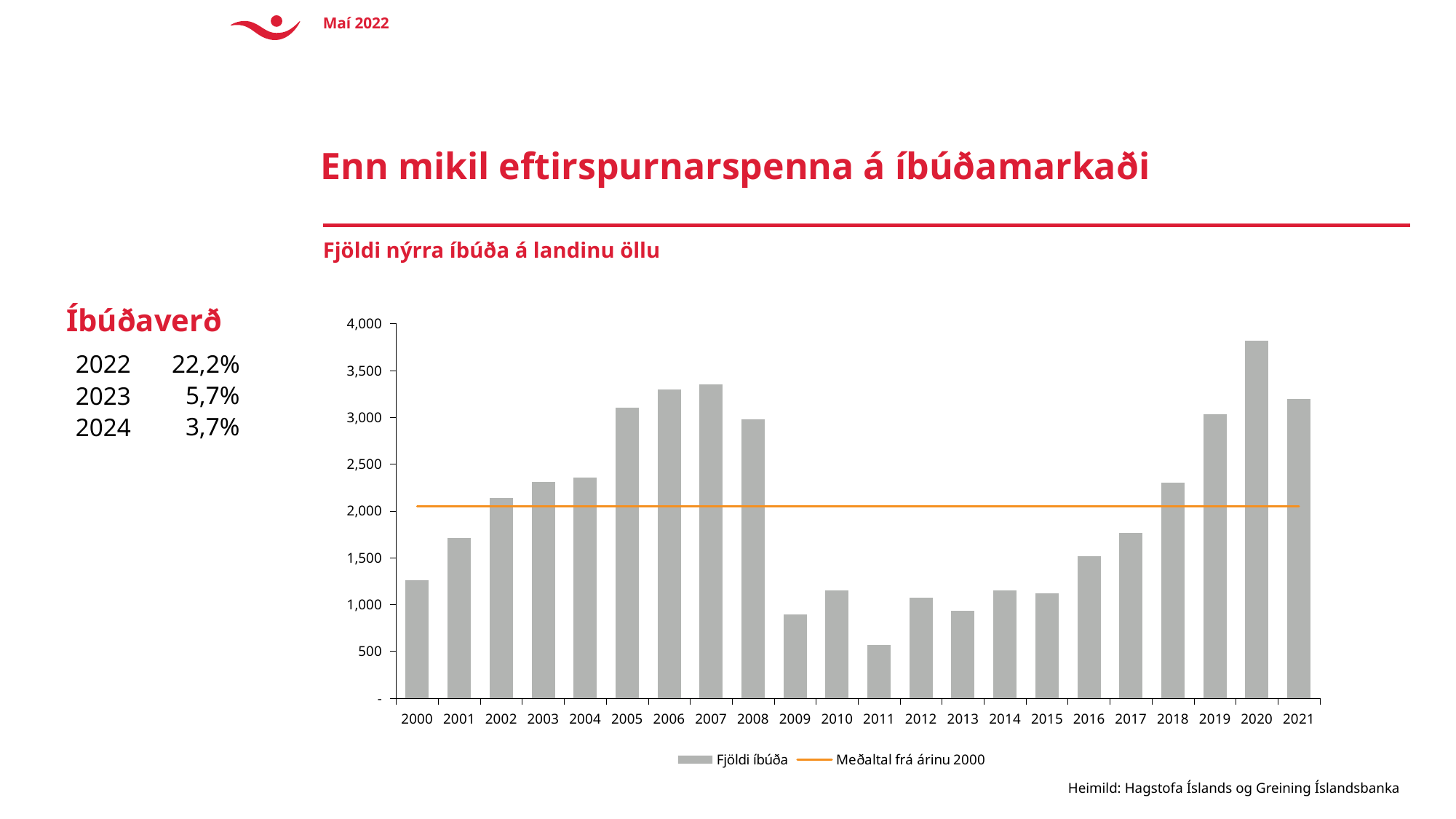
How many series does the chart legend list? 2 Is the value for 2009 greater or less than 1,000? less Which year has a higher value, 2002 or 2016? 2002 Is the value for 2020 greater or less than 3,500? greater Do the values generally rise or fall from 2007 to 2011? fall Which year has the lowest number of new apartments (Fjöldi íbúða)? 2011 How many years are shown on the x axis of the chart? 22 What kind of chart is shown on the slide? combination bar and line chart What is the label of the orange line in the legend? Meðaltal frá árinu 2000 Is the value for 2005 greater or less than 3,000? greater Which year has the highest number of new apartments (Fjöldi íbúða)? 2020